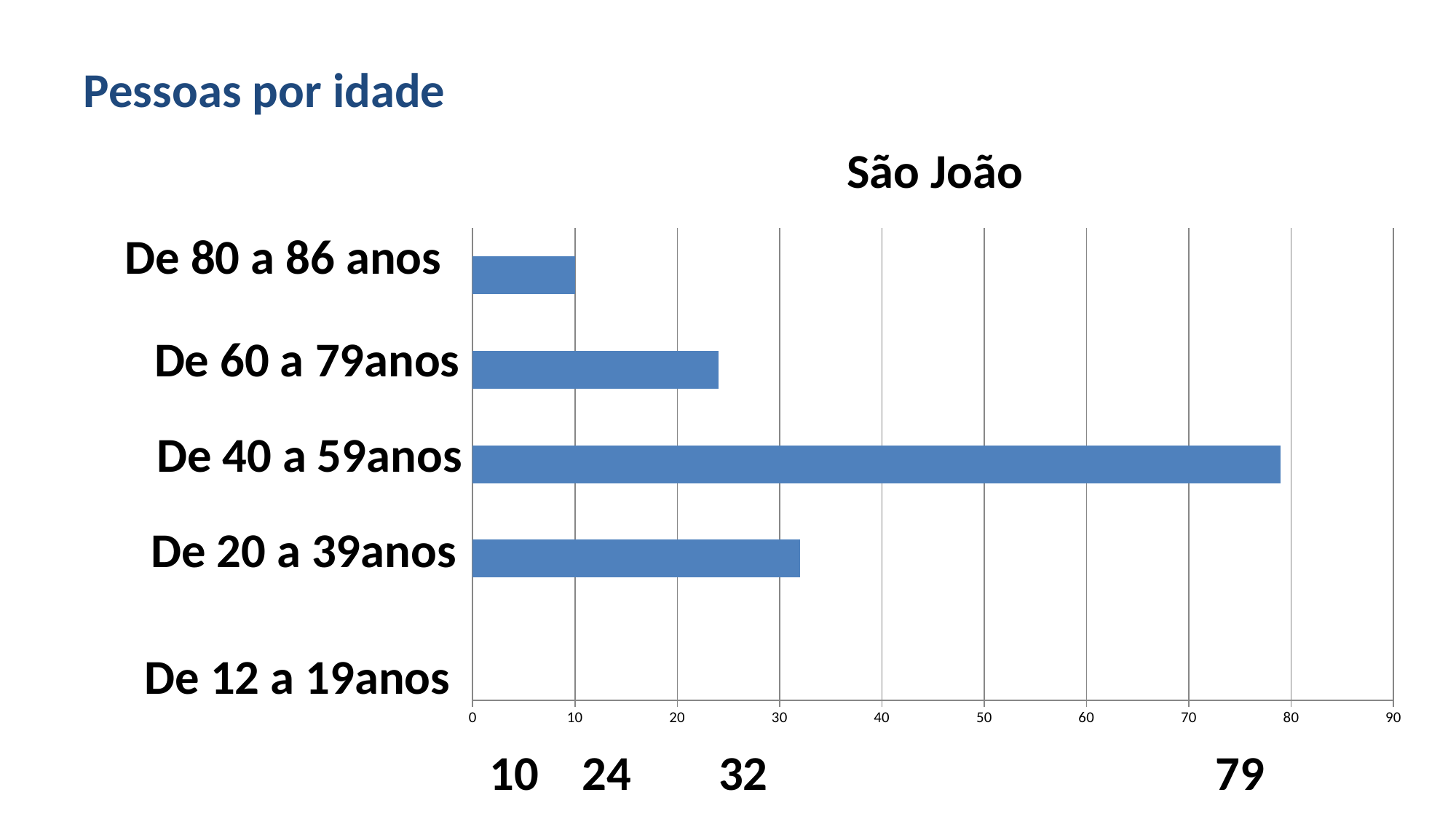
Is the value for De 40 a 59anos greater or less than 70? greater Which is larger, the value for De 60 a 79anos or the value for De 20 a 39anos? De 20 a 39anos What is the value for De 80 a 86 anos? 10 What is the value for De 40 a 59anos? 79 Which age category has the highest value? De 40 a 59anos What is the value for De 20 a 39anos? 32 What is the difference between the values for De 60 a 79anos and De 80 a 86 anos? 14 What is the value for De 60 a 79anos? 24 What kind of chart is shown on the slide? bar chart How many age categories are listed on the chart? 5 What is the difference between the values for De 40 a 59anos and De 20 a 39anos? 47 What is the title of the chart? São João